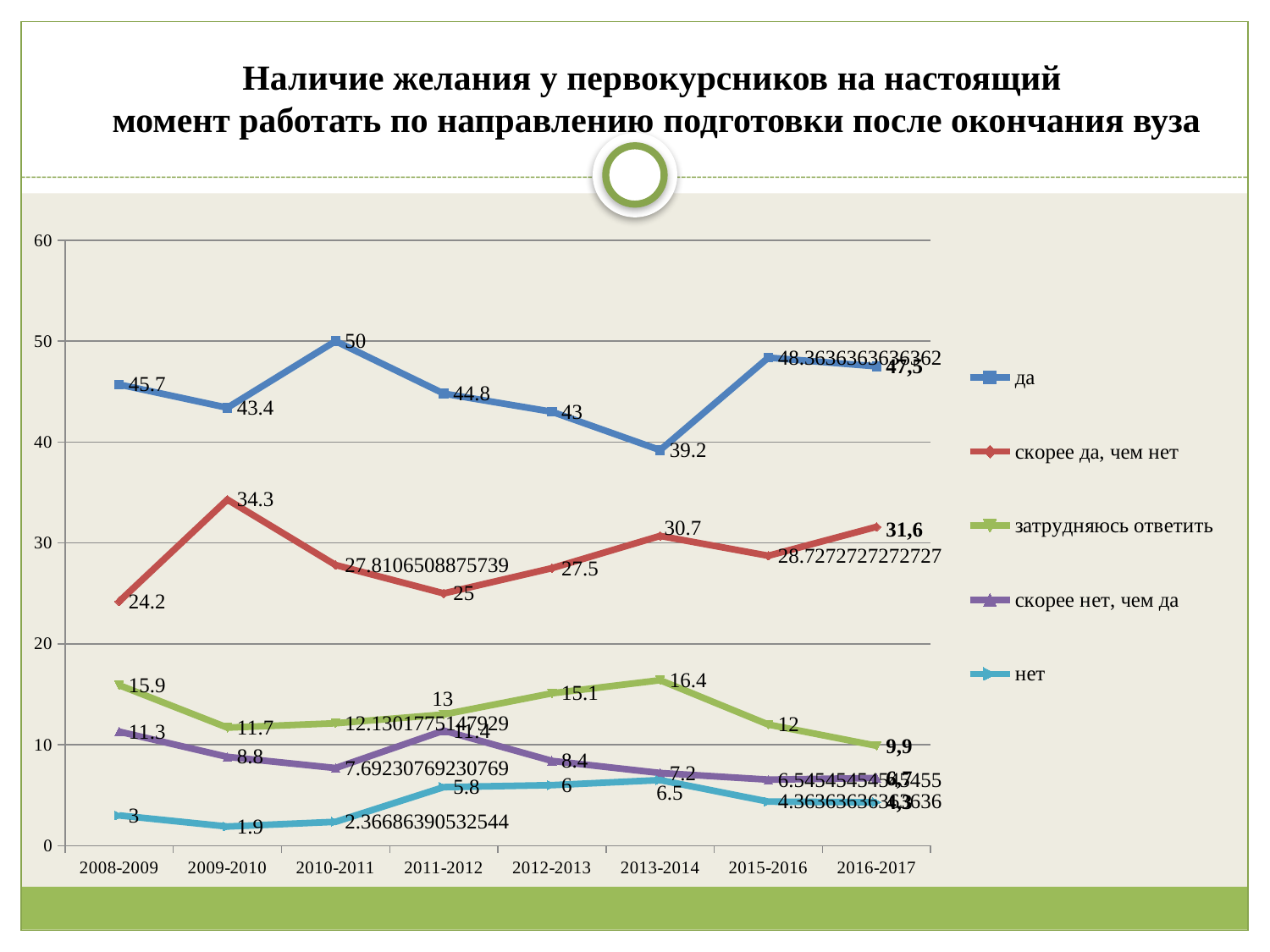
What is the value for the series "нет" in 2009-2010? 1.9 What type of chart is shown on the slide? line chart In which year is the value for the series "да" lowest? 2013-2014 What is the value for the series "скорее да, чем нет" in 2009-2010? 34.3 In which year is the value for the series "скорее да, чем нет" highest? 2009-2010 What is the value for the series "да" in 2010-2011? 50 What is the value for the series "затрудняюсь ответить" in 2013-2014? 16.4 What is the difference between the "да" values in 2010-2011 and 2013-2014? 10.8 How many academic years are shown on the x axis? 8 Is the value for "скорее да, чем нет" in 2008-2009 greater or less than 30? less How many series does the legend list? 5 Which is larger in 2011-2012: the value for "затрудняюсь ответить" or the value for "скорее нет, чем да"? затрудняюсь ответить